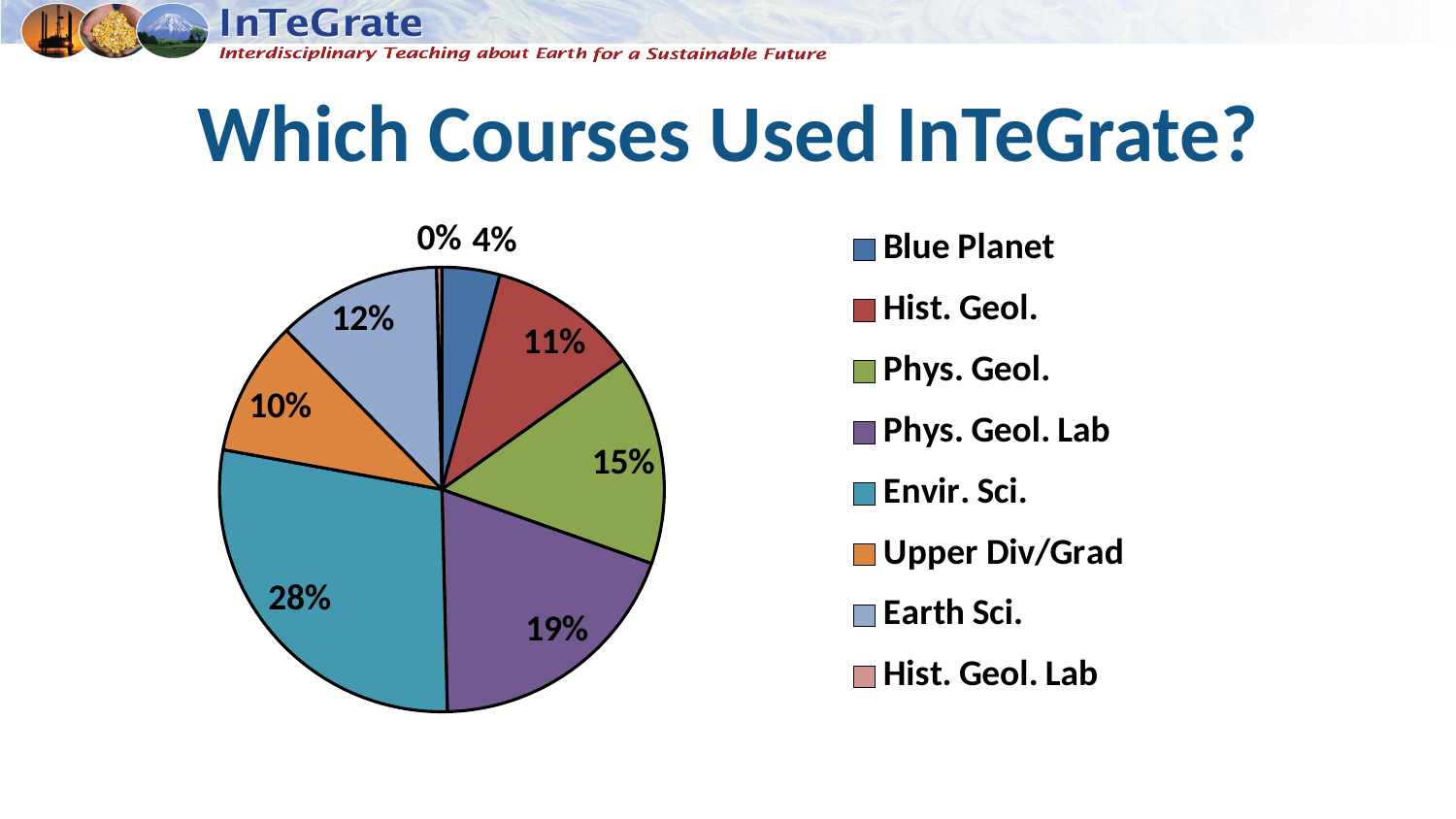
What percentage is shown for Hist. Geol. Lab? 0% How many courses does the legend list? 8 Which course has the smallest share of the pie? Hist. Geol. Lab What colour is the Upper Div/Grad slice in the legend? orange Which has a larger share, Earth Sci. or Upper Div/Grad? Earth Sci. What is the difference in percentage points between Envir. Sci. and Phys. Geol. Lab? 9 Which course has the largest share of the pie? Envir. Sci. What share of the pie does Envir. Sci. represent? 28% What type of chart is shown on the slide? pie chart What percentage is shown for Blue Planet? 4% What is the title of the chart on the slide? Which Courses Used InTeGrate? What percentage is shown for Phys. Geol. Lab? 19%